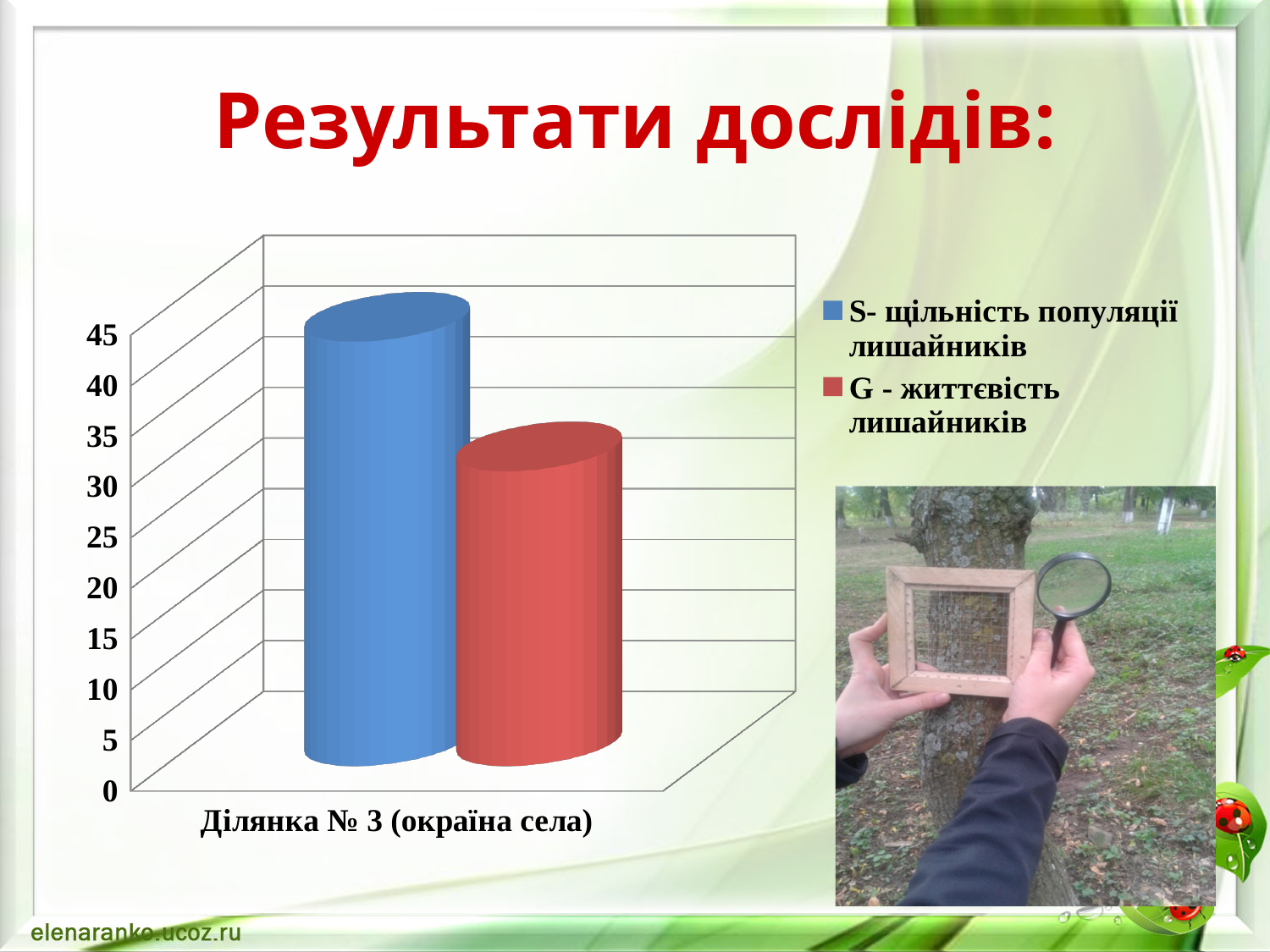
Which series has the lower value for Ділянка № 3 (окраїна села)? G - життєвість лишайників What is the highest value shown on the vertical axis of the chart? 45 Is the value for G - життєвість лишайників greater or less than 35? less Is the value for G - життєвість лишайників greater or less than 20? greater How many categories are shown on the x axis of the chart? 1 Is the value for S- щільність популяції лишайників greater or less than 35? greater Which series has the higher value for Ділянка № 3 (окраїна села)? S- щільність популяції лишайників How many series does the chart legend list? 2 What colour is the bar for G - життєвість лишайників? red Is the value for S- щільність популяції лишайників larger or smaller than the value for G - життєвість лишайників? larger What kind of chart is shown on the slide? bar chart What is the category label on the x axis of the chart? Ділянка № 3 (окраїна села)